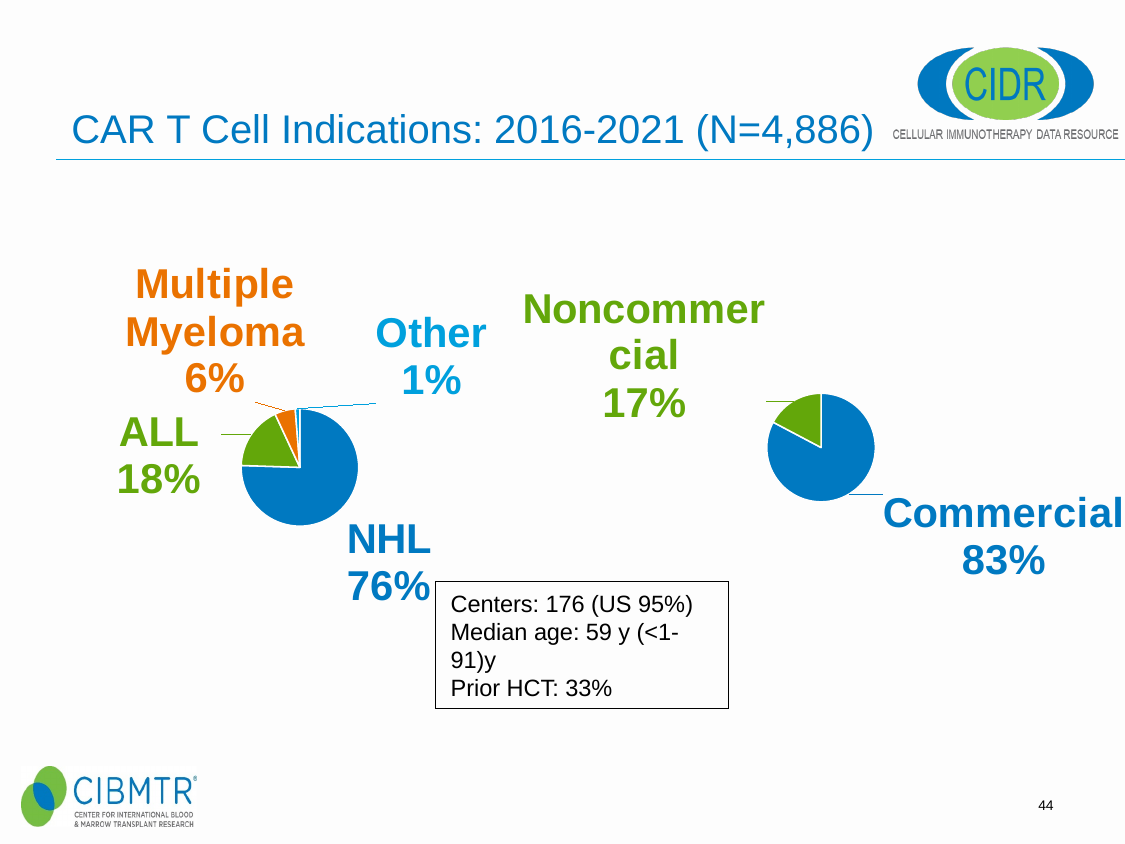
On the left pie chart, what share does NHL have? 76% On the left pie chart, what is the difference in percentage points between NHL and ALL? 58 On the left pie chart, which category has the largest share? NHL What is the title of the slide containing the charts? CAR T Cell Indications: 2016-2021 (N=4,886) On the left pie chart, how many categories are shown? 4 What kind of chart is used on the left of the slide? Pie chart On the left pie chart, what share does ALL have? 18% On the right pie chart, which is larger, Commercial or Noncommercial? Commercial On the right pie chart, what share is Commercial? 83% On the left pie chart, which category has the smallest share? Other On the right pie chart, what share is Noncommercial? 17% On the left pie chart, what share does Multiple Myeloma have? 6%